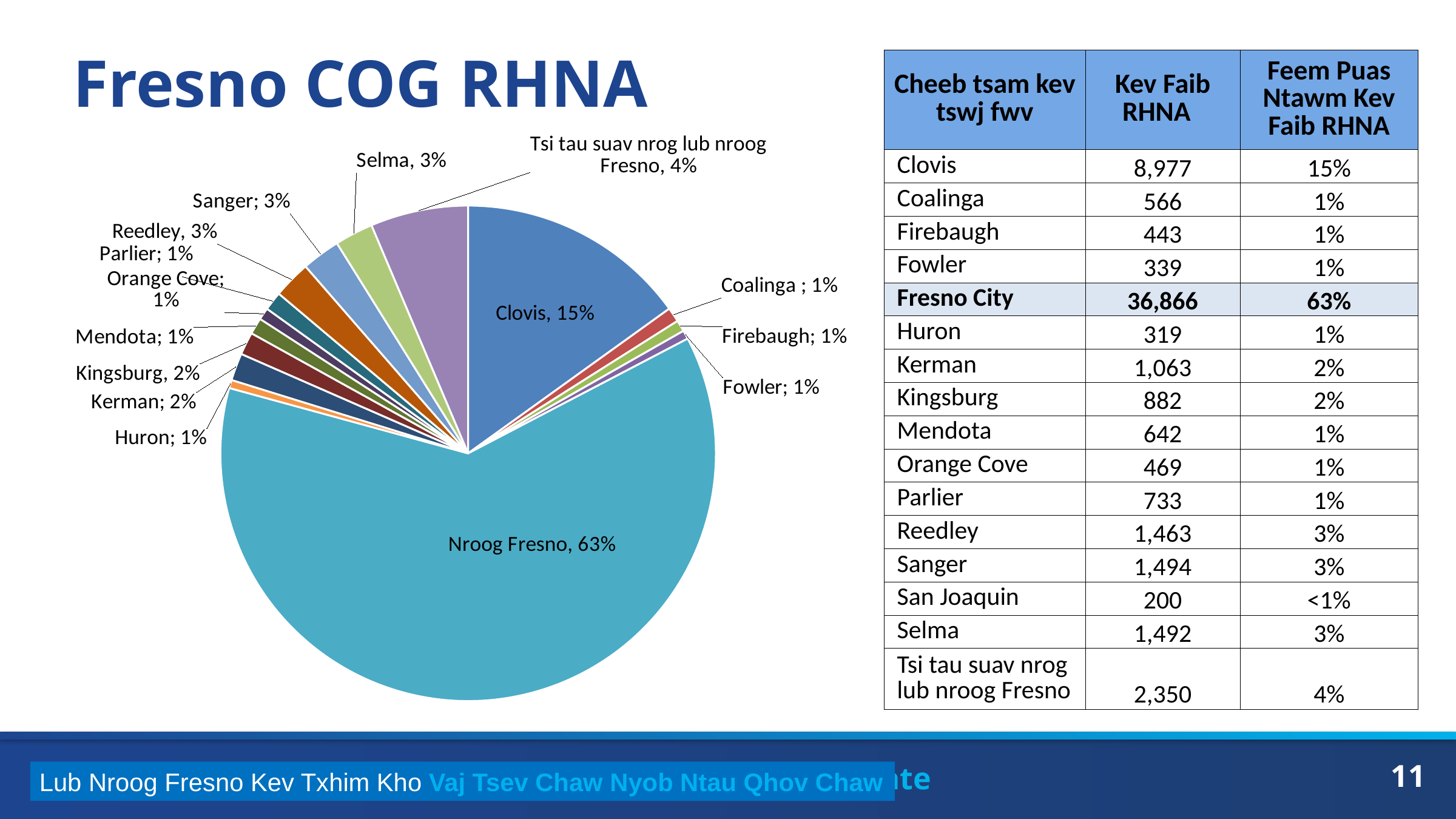
What percentage is shown for Coalinga in the pie chart? 1% Which is larger in the pie chart, Clovis or Selma? Clovis What percentage is shown for Selma in the pie chart? 3% Which slice of the pie chart is the largest? Nroog Fresno Which is larger in the pie chart, Kerman or Reedley? Reedley What share of the pie does Nroog Fresno hold? 63% What percentage is shown for Kingsburg in the pie chart? 2% What kind of chart is shown on the slide? pie chart What share of the pie does Clovis hold? 15% What is the title of the slide containing the pie chart? Fresno COG RHNA What is the difference in percentage points between Nroog Fresno and Clovis in the pie chart? 48 What percentage is shown for the slice labelled 'Tsi tau suav nrog lub nroog Fresno'? 4%